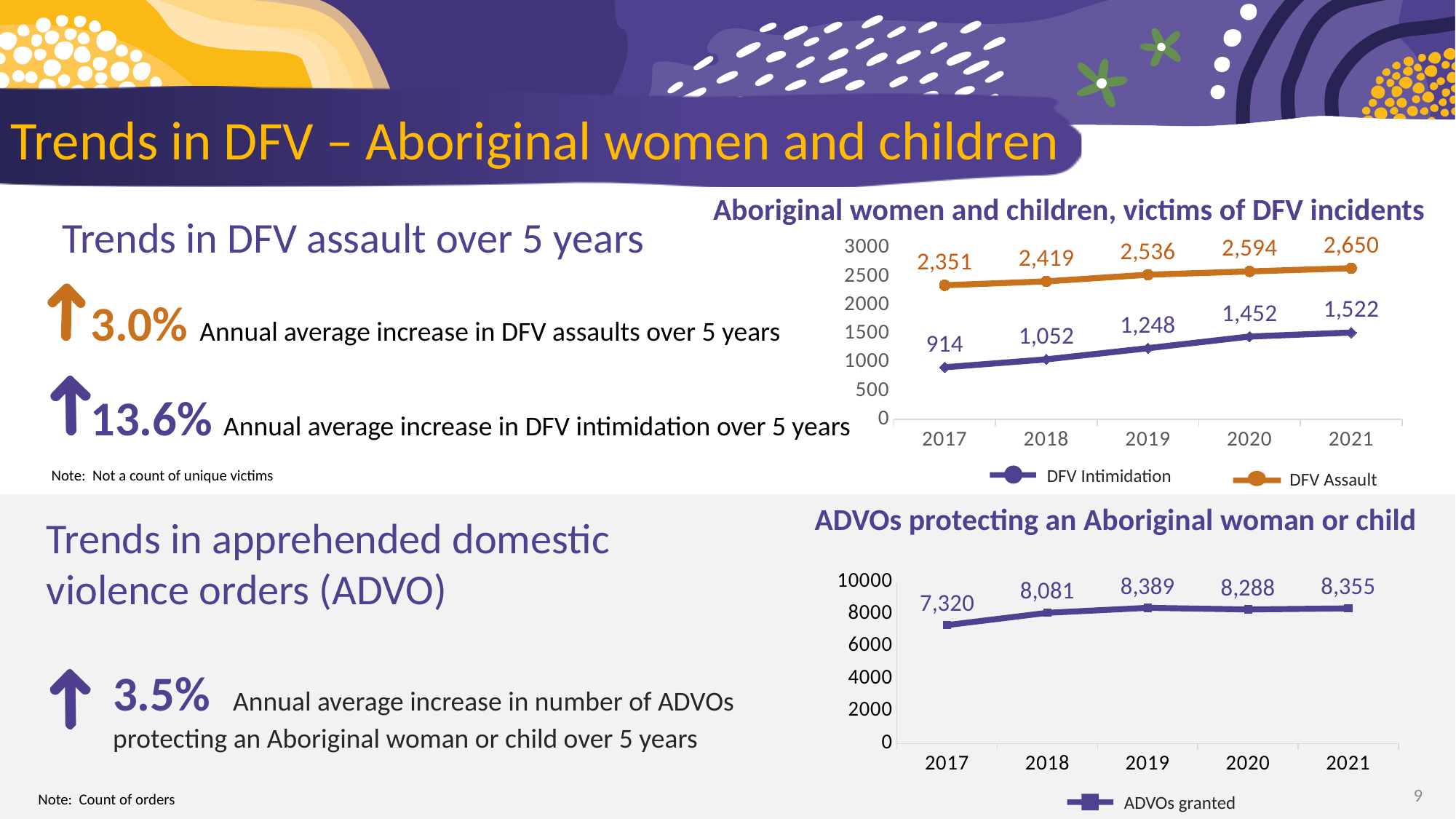
What kind of chart is 'ADVOs protecting an Aboriginal woman or child'? line chart In the 'ADVOs protecting an Aboriginal woman or child' chart, which is larger, the value for 2020 or the value for 2018? 2020 In the 'Aboriginal women and children, victims of DFV incidents' chart, does DFV Intimidation rise or fall from 2017 to 2021? rise In the 'ADVOs protecting an Aboriginal woman or child' chart, what is the value for 2019? 8,389 In the 'Aboriginal women and children, victims of DFV incidents' chart, what is the DFV Assault value for 2021? 2,650 In the 'ADVOs protecting an Aboriginal woman or child' chart, which year has the highest value? 2019 In the 'Aboriginal women and children, victims of DFV incidents' chart, what is the difference between DFV Assault and DFV Intimidation in 2019? 1,288 In the 'Aboriginal women and children, victims of DFV incidents' chart, how many series does the legend list? 2 In the 'Aboriginal women and children, victims of DFV incidents' chart, which year has the lowest DFV Intimidation value? 2017 In the 'ADVOs protecting an Aboriginal woman or child' chart, how many years are plotted on the x axis? 5 In the 'Aboriginal women and children, victims of DFV incidents' chart, what is the DFV Intimidation value for 2017? 914 In the 'ADVOs protecting an Aboriginal woman or child' chart, what is the difference between the 2021 and 2017 values? 1,035